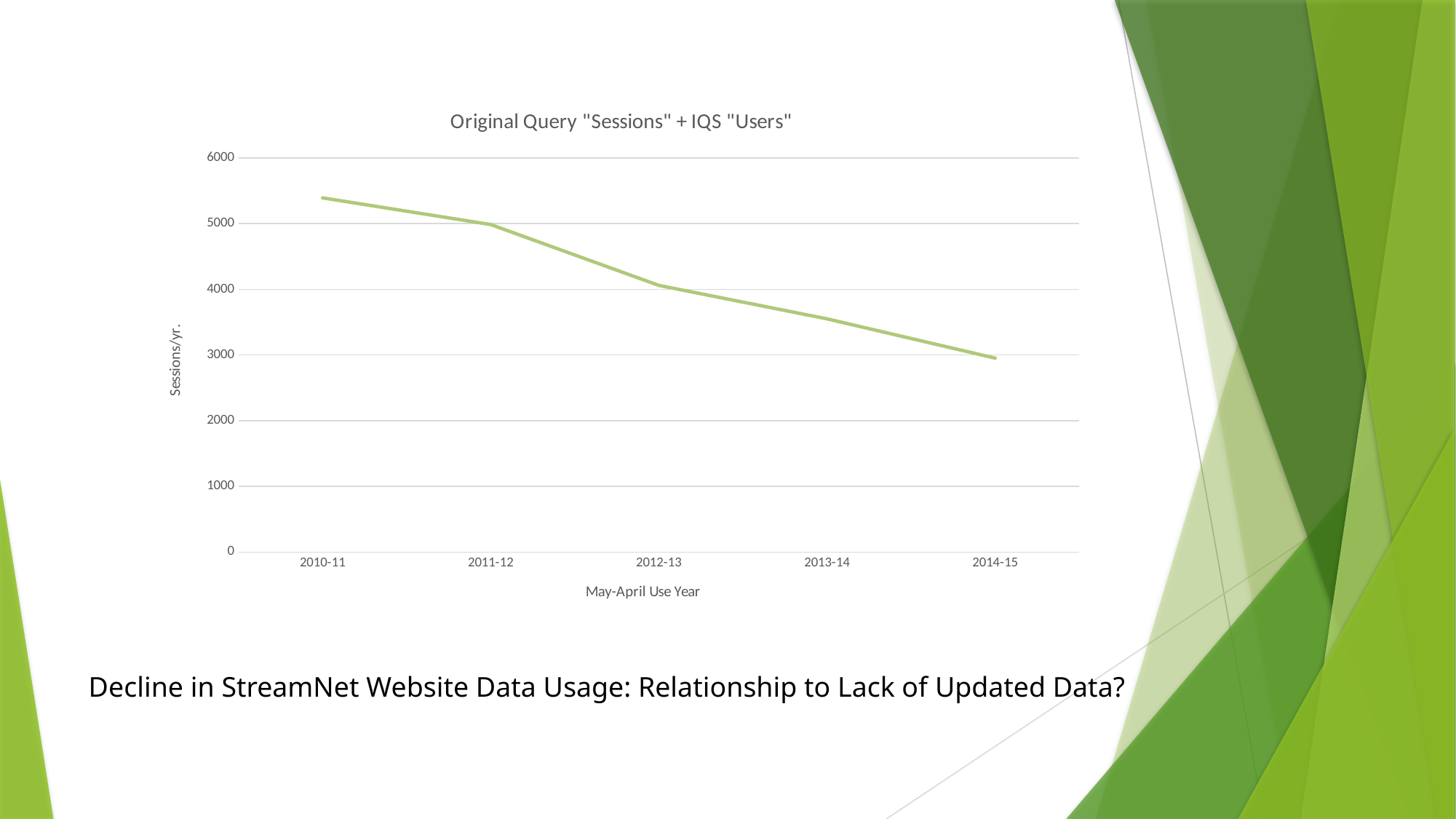
Is the value for 2012-13 greater or less than 5000? less What kind of chart is shown on the slide? line chart Is the value for 2013-14 greater or less than 4000? less Which use year has the lowest number of sessions? 2014-15 Is the value for 2010-11 greater or less than 5000? greater Which has more sessions, 2011-12 or 2013-14? 2011-12 Do the sessions per year rise or fall from 2010-11 to 2014-15? fall What is the label on the vertical axis of the chart? Sessions/yr. Which use year has the highest number of sessions? 2010-11 What is the title of the chart? Original Query "Sessions" + IQS "Users" How many use years are plotted along the x axis? 5